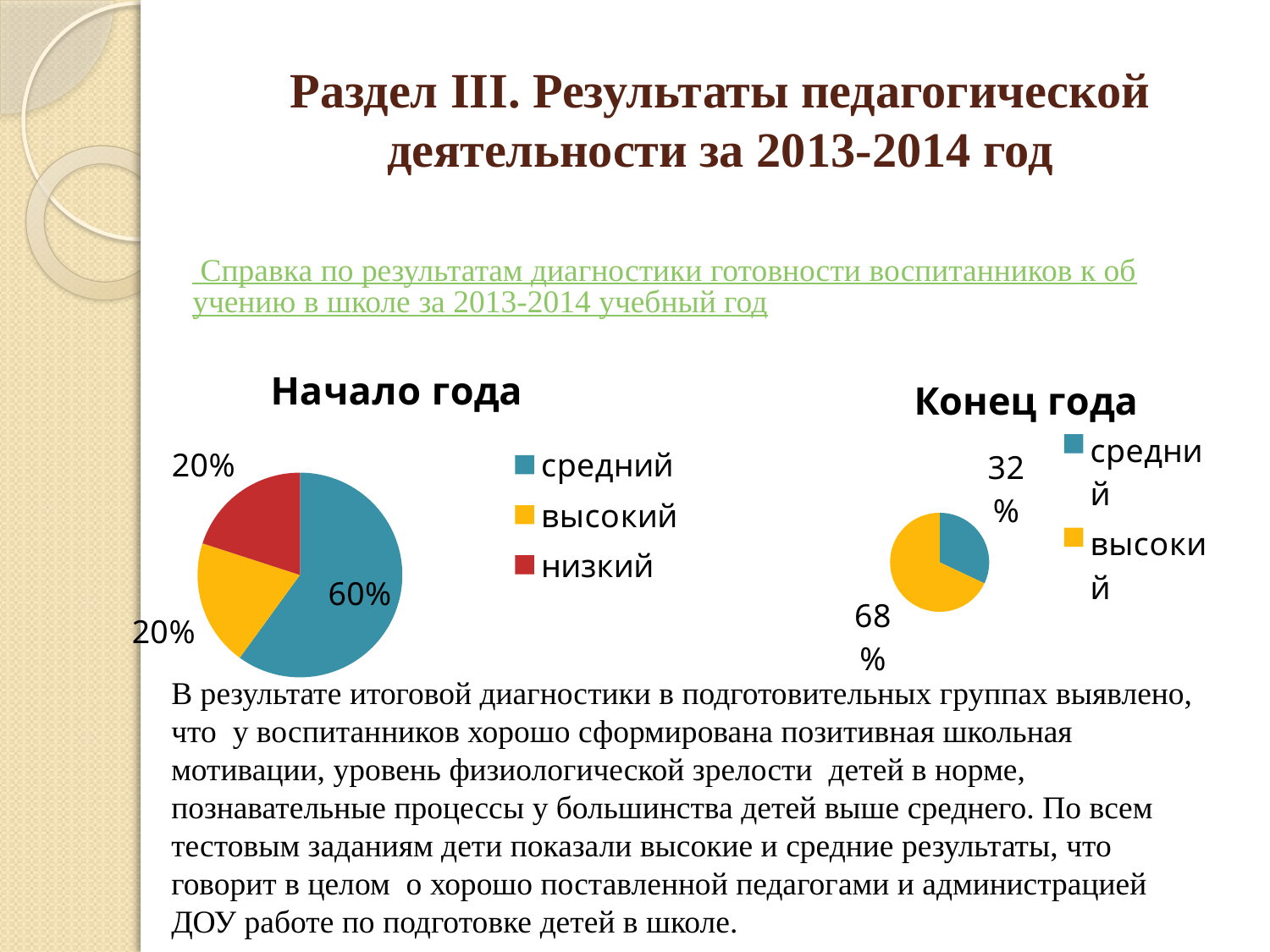
In the 'Начало года' chart, what share does 'низкий' have? 20% In the 'Конец года' chart, which category has the largest slice? высокий What type of chart is the 'Конец года' chart? pie chart In the 'Начало года' chart, which category has the largest slice? средний In the 'Конец года' chart, which category has the smallest slice? средний In the 'Конец года' chart, what share does 'высокий' have? 68% In the 'Конец года' chart, what is the difference between the 'высокий' and 'средний' shares? 36% In the 'Начало года' chart, what share does 'средний' have? 60% In the 'Конец года' chart, what share does 'средний' have? 32% How many categories does the legend of the 'Начало года' chart list? 3 How many categories does the legend of the 'Конец года' chart list? 2 In the 'Начало года' chart, what is the difference between the 'средний' and 'высокий' shares? 40%